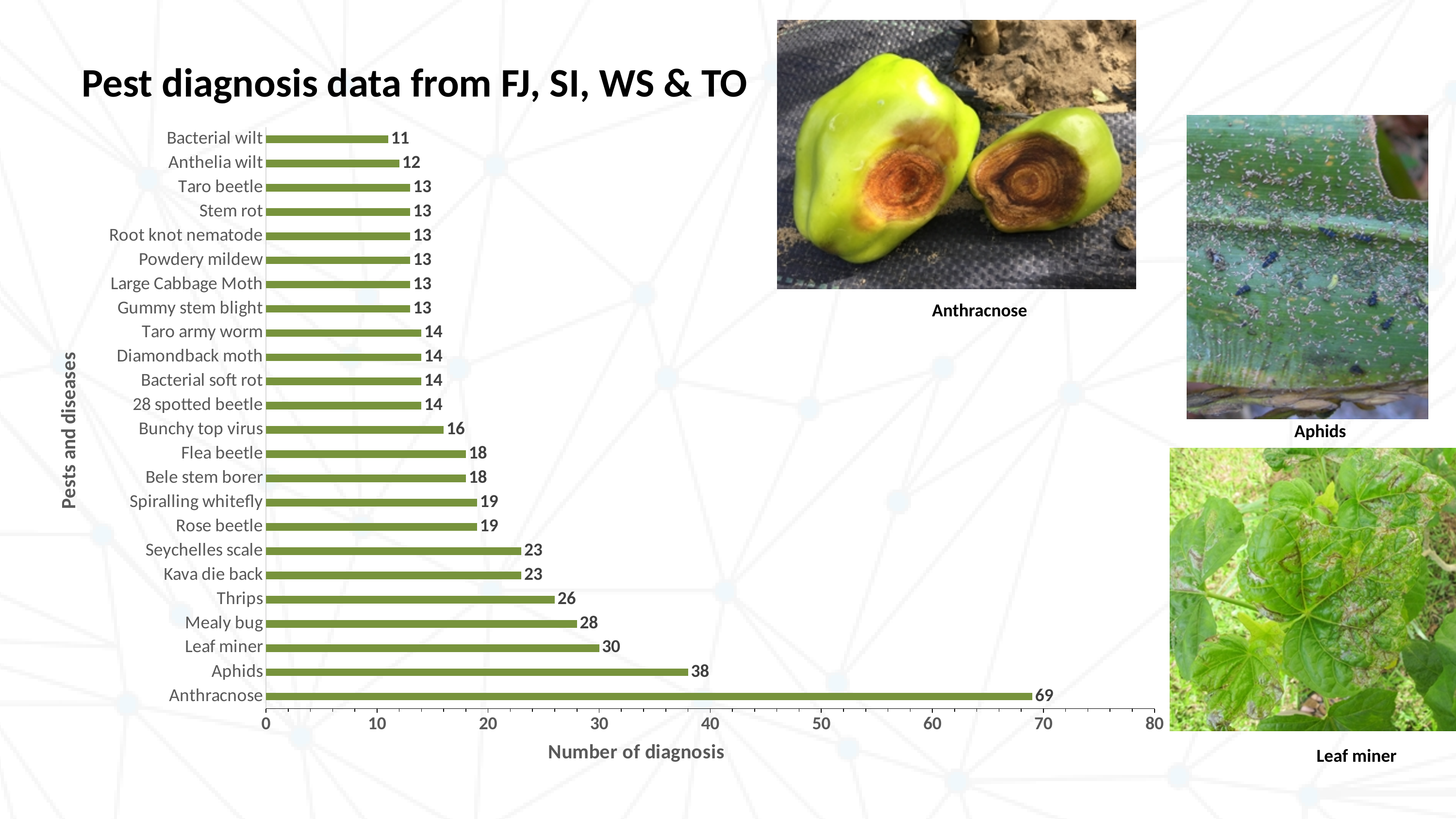
Which pest or disease has the highest number of diagnosis? Anthracnose What is the difference between the number of diagnosis for Mealy bug and Thrips? 2 Which has a larger number of diagnosis, Kava die back or Rose beetle? Kava die back What is the difference between the number of diagnosis for Anthracnose and Aphids? 31 What is the number of diagnosis for Leaf miner? 30 What is the number of diagnosis for Anthracnose? 69 Is the value for Aphids greater or less than 40? less What is the label of the horizontal axis of the chart? Number of diagnosis How many pests and diseases are shown in the chart? 24 What is the number of diagnosis for Bunchy top virus? 16 What kind of chart is shown on the slide? Bar chart Which pest or disease has the lowest number of diagnosis? Bacterial wilt